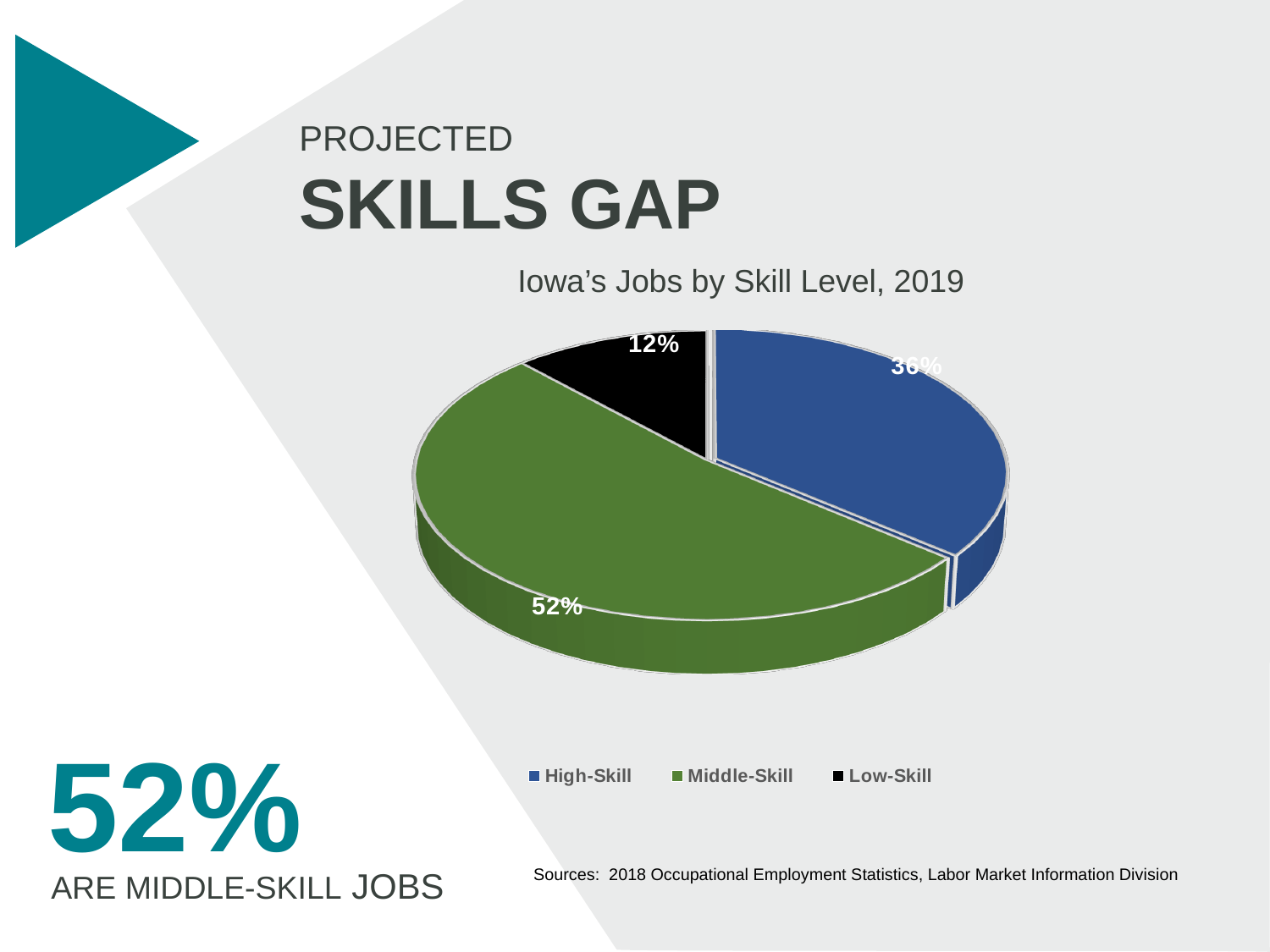
Which skill level has the smallest share of Iowa's jobs? Low-Skill Which skill level has the largest share of Iowa's jobs? Middle-Skill What share of Iowa's jobs are Middle-Skill? 52% Which is larger, the High-Skill share or the Low-Skill share? High-Skill What colour represents Low-Skill in the pie chart? Black How many skill-level categories does the pie chart show? 3 What type of chart is used to show Iowa's jobs by skill level? Pie chart What is the difference in percentage points between the Middle-Skill and High-Skill shares? 16 What is the title of the chart? Iowa's Jobs by Skill Level, 2019 What is the difference in percentage points between the High-Skill and Low-Skill shares? 24 What share of Iowa's jobs are Low-Skill? 12% What share of Iowa's jobs are High-Skill? 36%